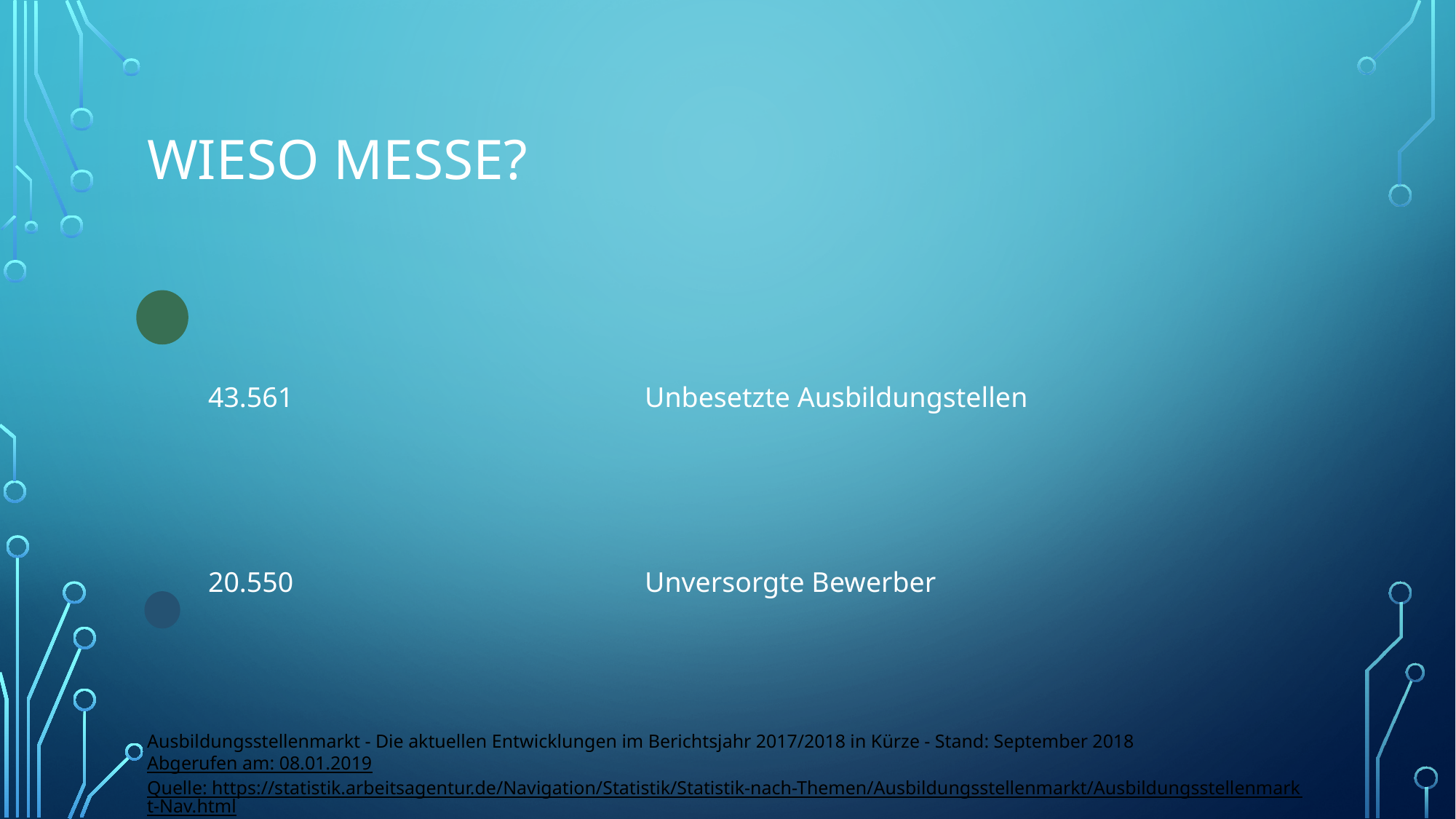
What is the title of the slide? Wieso Messe? What is the difference between the value for Unbesetzte Ausbildungstellen and the value for Unversorgte Bewerber? 23.011 Which category has the higher value, Unbesetzte Ausbildungstellen or Unversorgte Bewerber? Unbesetzte Ausbildungstellen What is the value shown for Unversorgte Bewerber? 20.550 What is the value shown for Unbesetzte Ausbildungstellen? 43.561 How many categories are shown with values on the slide? 2 What colour is the circle next to the larger value, 43.561? Green Which category has the highest value on the slide? Unbesetzte Ausbildungstellen Which category has the lowest value on the slide? Unversorgte Bewerber